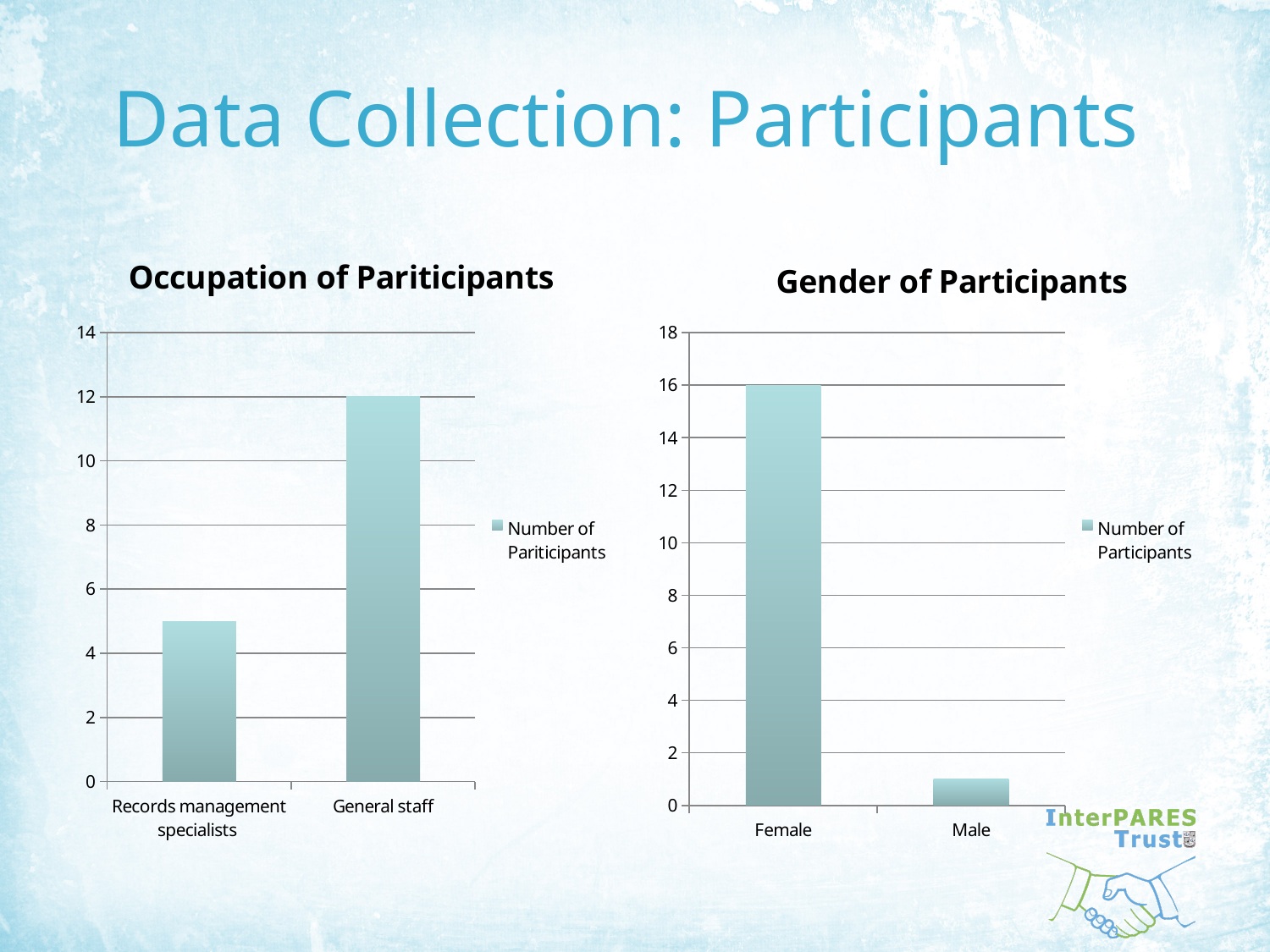
What is the legend entry in the 'Occupation of Pariticipants' chart? Number of Participants In the 'Occupation of Pariticipants' chart, what is the value for General staff? 12 In the 'Occupation of Pariticipants' chart, is the value for Records management specialists greater or less than 6? less In the 'Gender of Participants' chart, which is larger, Female or Male? Female In the 'Gender of Participants' chart, is the value for Male greater or less than 2? less In the 'Occupation of Pariticipants' chart, is the value for Records management specialists greater or less than 4? greater In the 'Gender of Participants' chart, which category has the lowest value? Male In the 'Gender of Participants' chart, what is the value for Female? 16 What kind of chart is the 'Gender of Participants' chart? Bar chart How many series does the legend of the 'Gender of Participants' chart list? 1 How many categories are shown in the 'Occupation of Pariticipants' chart? 2 In the 'Occupation of Pariticipants' chart, which category has the highest value? General staff